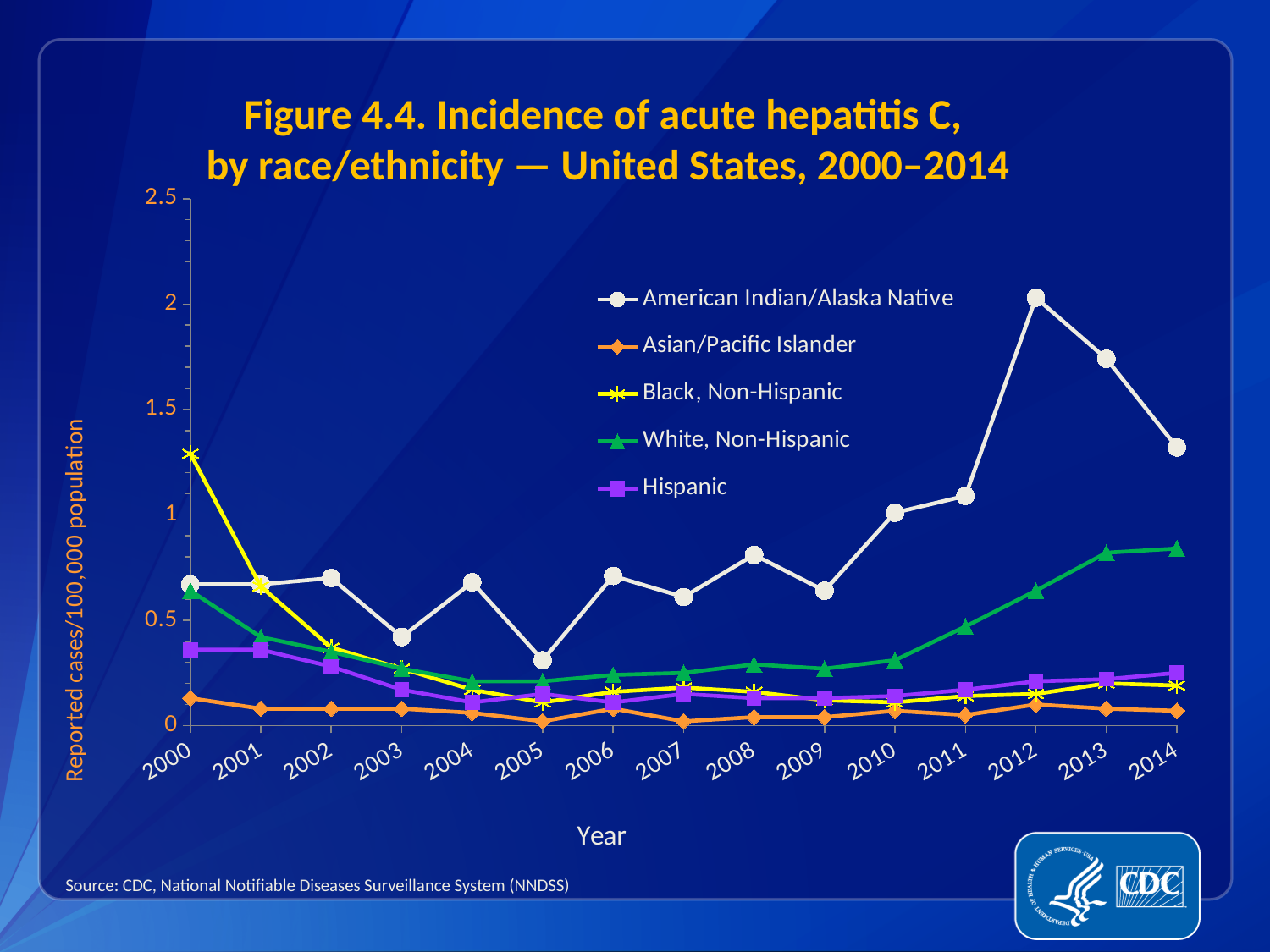
Which group had the highest incidence in 2000? Black, Non-Hispanic Is the value for Black, Non-Hispanic in 2000 greater or less than 1? greater In 2014, which is larger: the value for White, Non-Hispanic or the value for Hispanic? White, Non-Hispanic Does the White, Non-Hispanic series rise or fall from 2010 to 2014? Rise How many series does the legend list? 5 Which race/ethnicity group has the lowest incidence in 2014? Asian/Pacific Islander How many years are plotted along the x axis? 15 Is the value for White, Non-Hispanic in 2014 greater or less than 0.5? greater What kind of chart is shown on the slide? Line chart In which year does the American Indian/Alaska Native series reach its highest value? 2012 Is the value for American Indian/Alaska Native in 2012 greater or less than 1.5? greater Which race/ethnicity group has the highest incidence in 2014? American Indian/Alaska Native